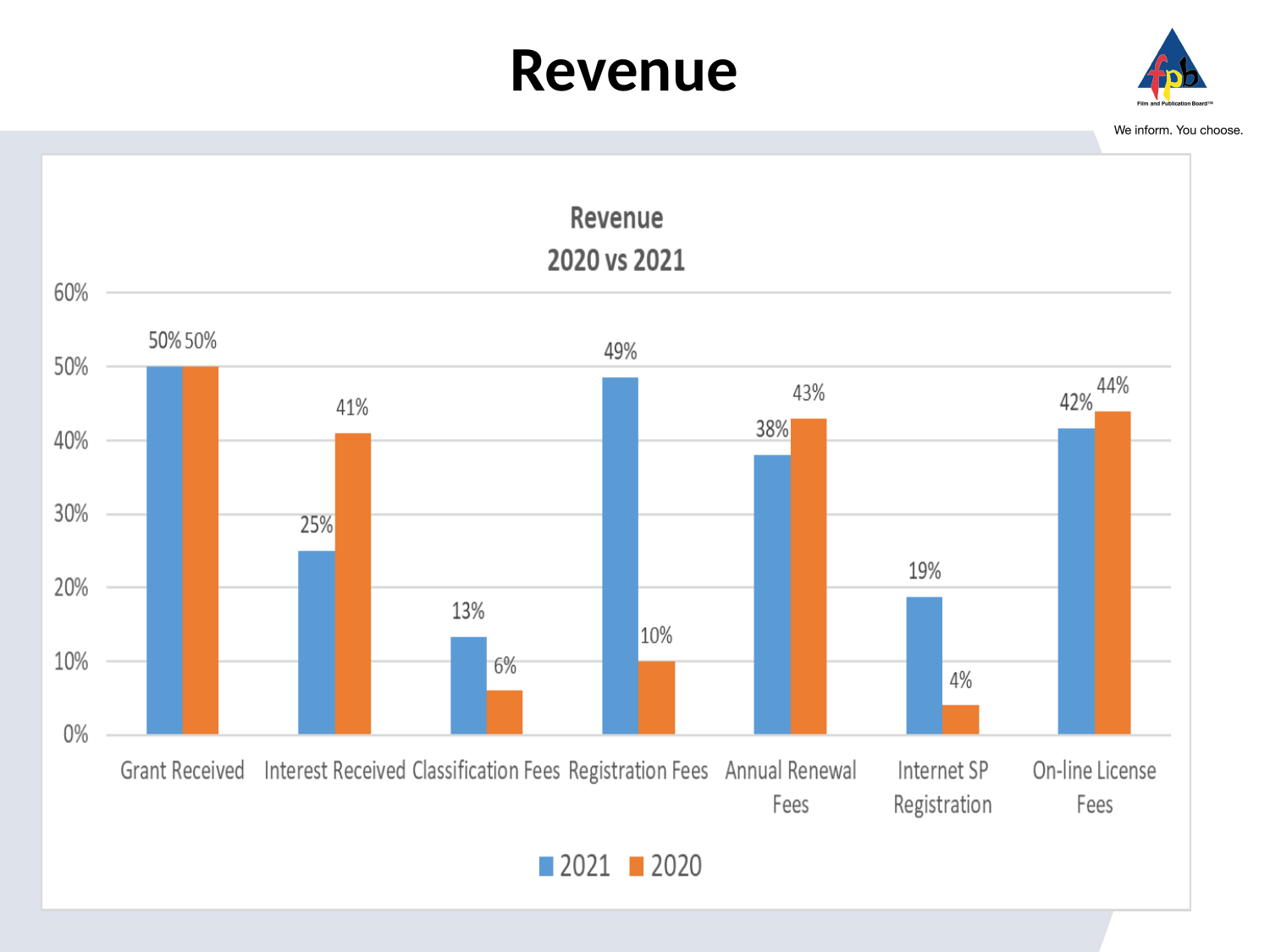
What is the difference between the 2021 and 2020 values for Registration Fees? 39% Which category has the lowest 2020 value? Internet SP Registration Which is larger for Annual Renewal Fees, the 2021 value or the 2020 value? 2020 How many categories are shown on the x axis? 7 How many series does the legend list? 2 Is the 2021 value for Classification Fees greater or less than 10%? greater What is the 2021 value for Registration Fees? 49% Which category has the highest 2021 value? Grant Received What kind of chart is shown? Bar chart What is the 2020 value for Internet SP Registration? 4% Which colour represents the 2020 series? Orange What is the 2020 value for Interest Received? 41%